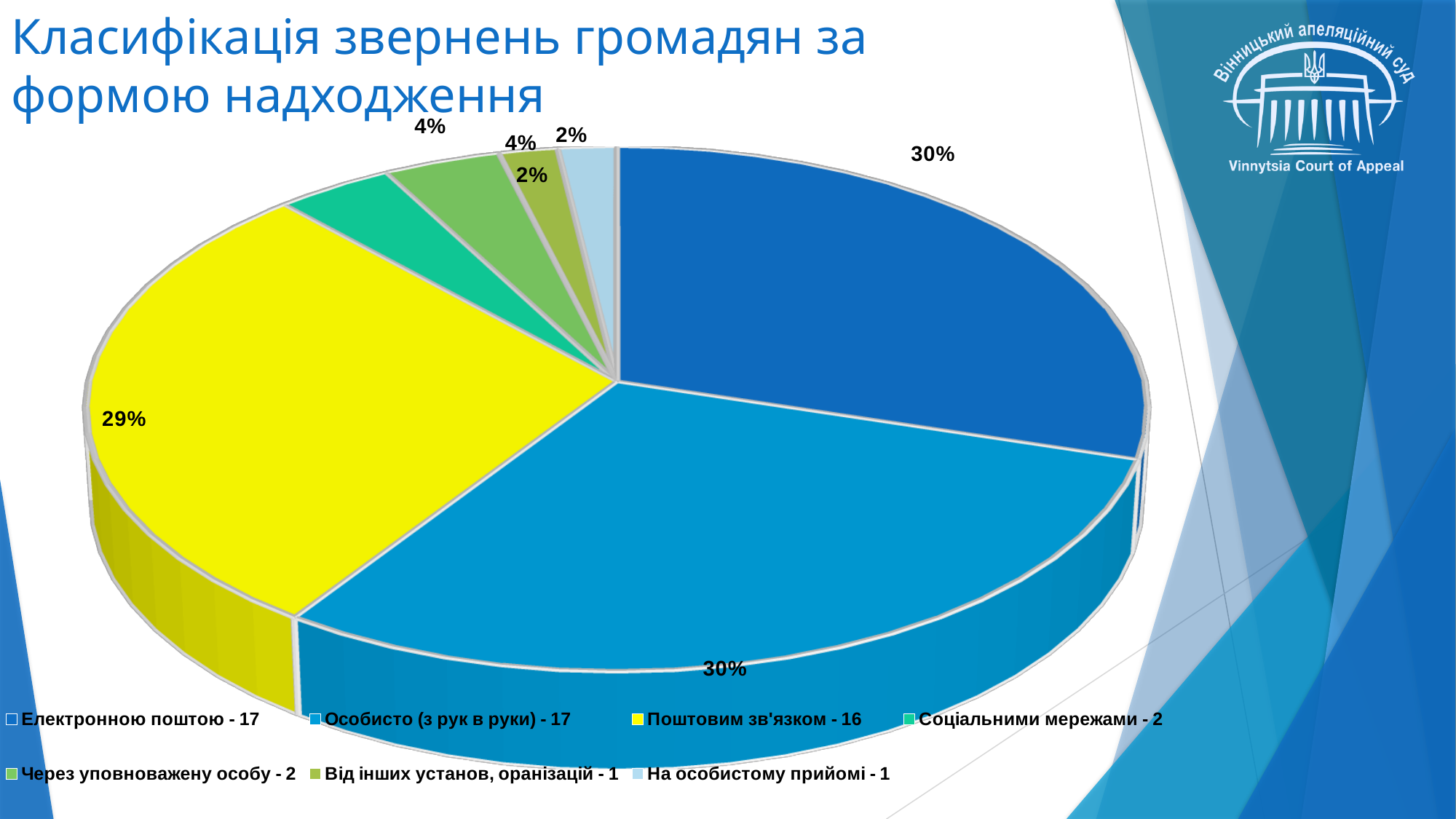
How many slices does the pie chart have? 7 What share of the pie does "Соціальними мережами" represent? 4% What is the difference between the number of appeals received "Електронною поштою" and "Від інших установ, оранізацій"? 16 What share of the pie does "Електронною поштою" represent? 30% What colour is the slice for "Поштовим зв'язком"? yellow What share of the pie does "Поштовим зв'язком" represent? 29% According to the legend, how many appeals were received "Через уповноважену особу"? 2 What kind of chart is shown on the slide? pie chart According to the legend, how many appeals were received "Особисто (з рук в руки)"? 17 Which is larger: the number of appeals received "Поштовим зв'язком" or "Соціальними мережами"? Поштовим зв'язком What is the title of the chart on the slide? Класифікація звернень громадян за формою надходження